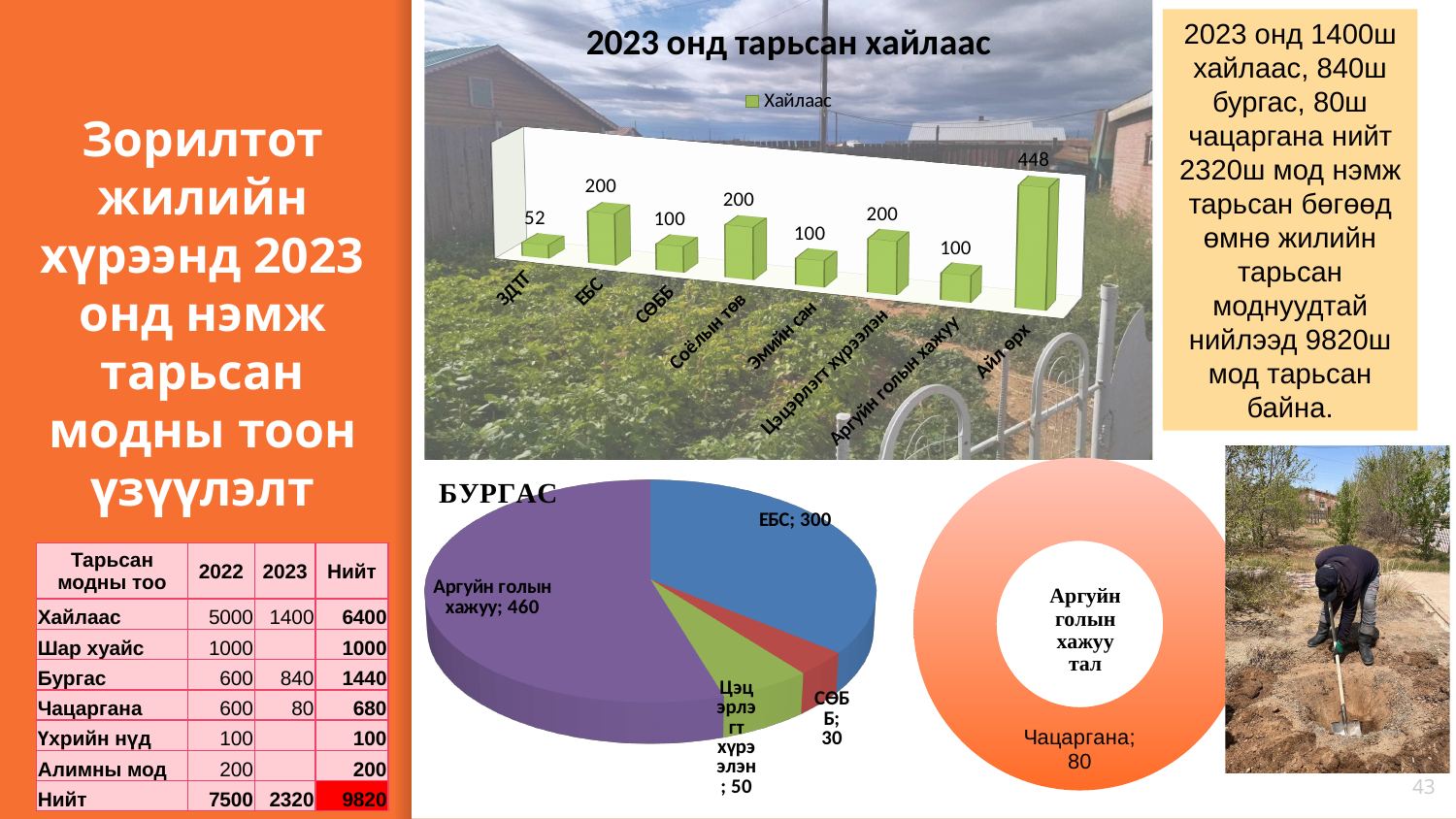
In the chart titled "2023 онд тарьсан хайлаас", what is the value for Айл өрх? 448 In the pie chart titled "БУРГАС", what is the value for ЕБС? 300 In the pie chart titled "БУРГАС", which is larger, the value for СӨББ or the value for Цэцэрлэгт хүрээлэн? Цэцэрлэгт хүрээлэн In the chart titled "2023 онд тарьсан хайлаас", which category has the highest value? Айл өрх In the chart titled "2023 онд тарьсан хайлаас", what is the difference between the values for Айл өрх and ЕБС? 248 In the chart titled "2023 онд тарьсан хайлаас", which category has the lowest value? ЗДТГ In the chart titled "2023 онд тарьсан хайлаас", how many categories are shown? 8 In the doughnut chart at the bottom right, what is the value shown for Чацаргана? 80 In the pie chart titled "БУРГАС", which slice is the largest? Аргуйн голын хажуу In the chart titled "2023 онд тарьсан хайлаас", what kind of chart is it? Bar chart In the chart titled "2023 онд тарьсан хайлаас", what is the value for ЗДТГ? 52 In the chart titled "2023 онд тарьсан хайлаас", what is the only series listed in the legend? Хайлаас